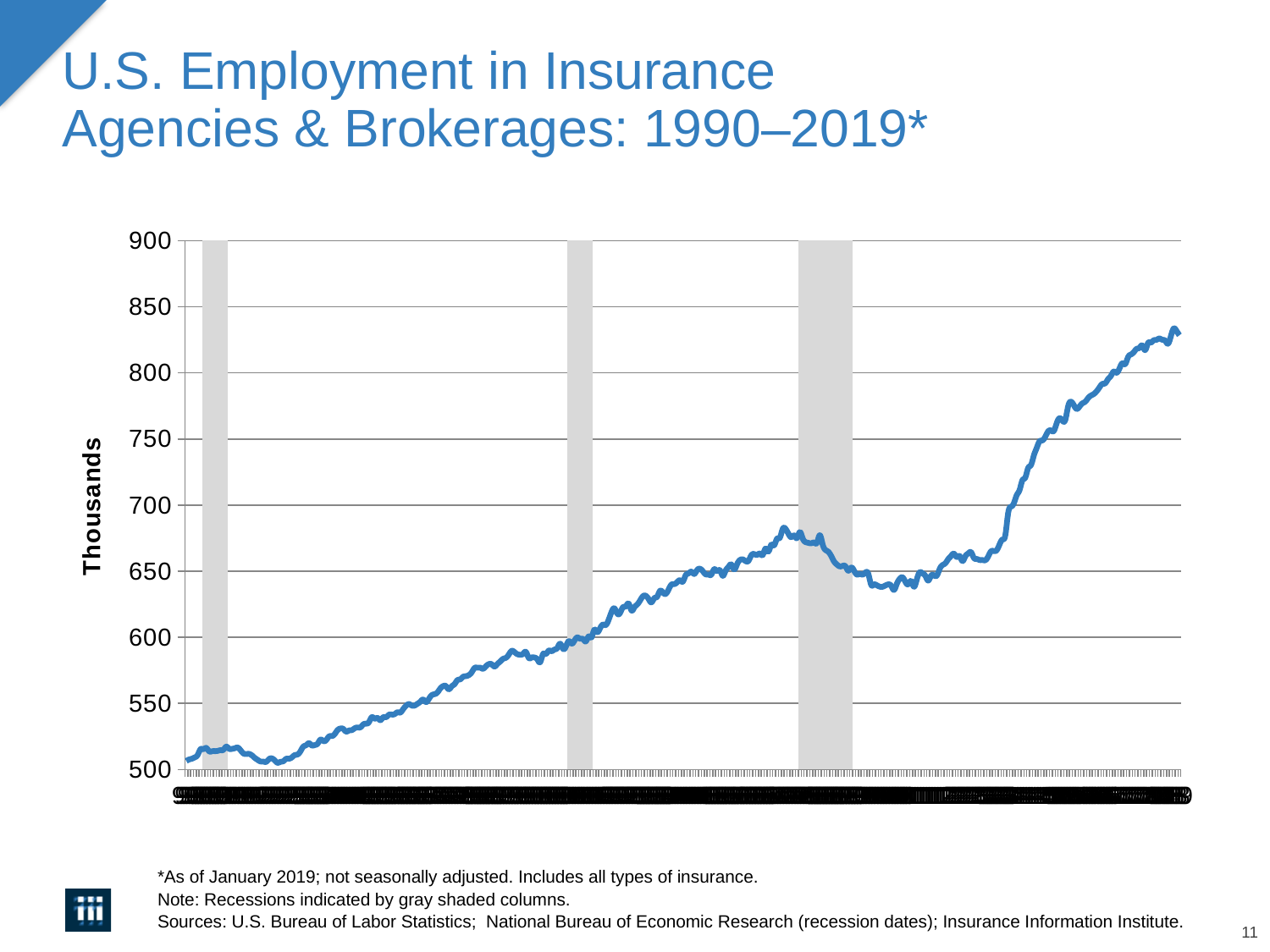
Is the value at the right end of the line greater or less than 850? less How many gray shaded recession columns are shown on the chart? 3 Is the value at the right end of the line (January 2019) greater or less than 800? greater Is the peak reached just before the third gray shaded column greater or less than 700? less What is the highest value shown on the vertical axis? 900 Overall, do the values rise or fall from the left of the chart to the right? rise What kind of chart is shown on the slide? line chart What is the label on the vertical axis? Thousands Is the value at the right end of the line larger or smaller than the value at the left end? larger What is the title of the chart? U.S. Employment in Insurance Agencies & Brokerages: 1990–2019*